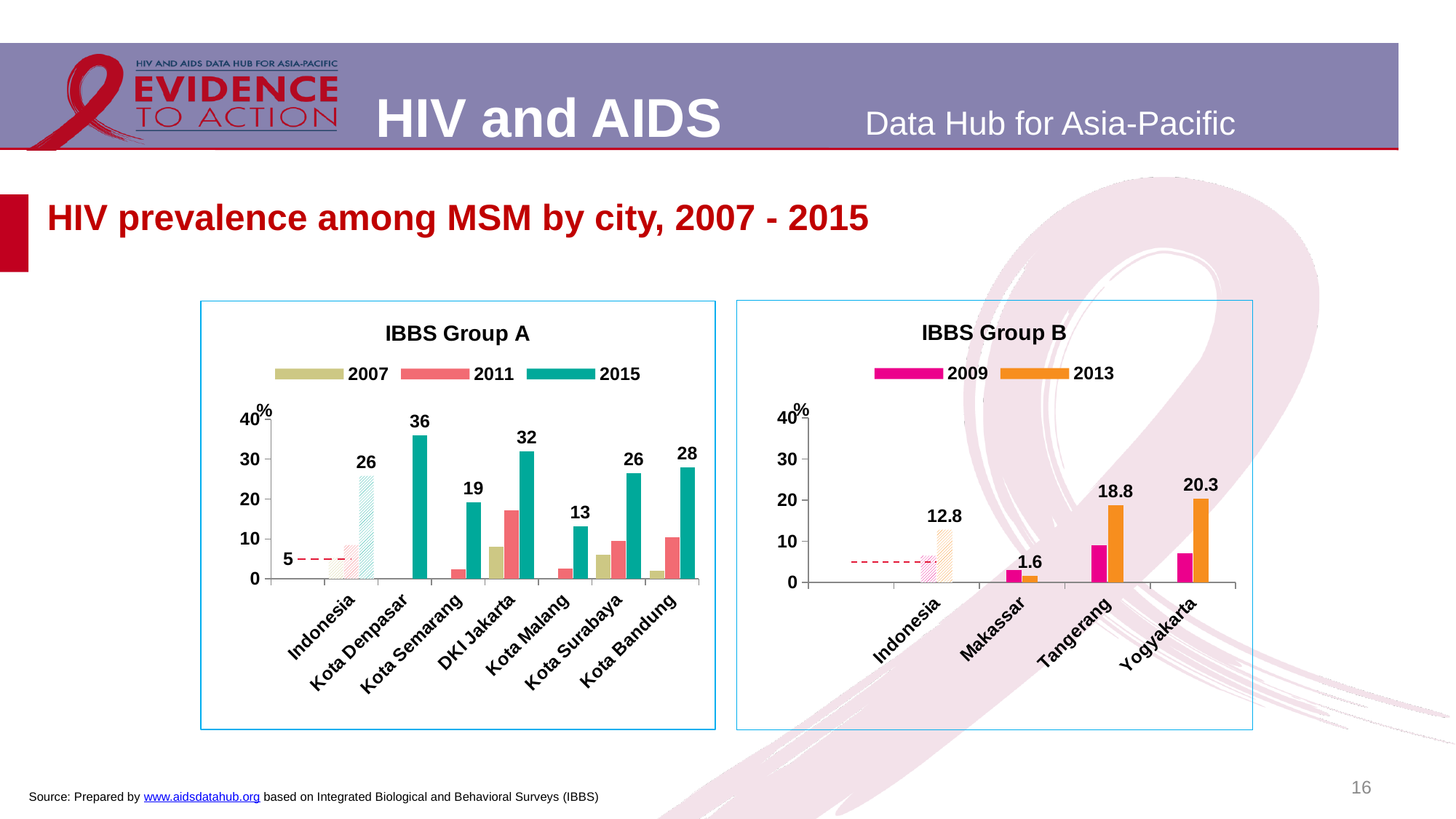
In the IBBS Group A chart, which category has the lowest 2015 value? Kota Malang In the IBBS Group B chart, which category has the highest 2013 value? Yogyakarta In the IBBS Group A chart, what is the 2015 value for Kota Denpasar? 36 In the IBBS Group B chart, what is the 2013 value for Yogyakarta? 20.3 In the IBBS Group A chart, how many series does the legend list? 3 In the IBBS Group A chart, which city has the highest 2015 value? Kota Denpasar In the IBBS Group A chart, how many categories are shown on the x axis? 7 In the IBBS Group B chart, what is the difference between the 2013 values for Yogyakarta and Tangerang? 1.5 In the IBBS Group A chart, what is the difference between the 2015 values for Kota Denpasar and DKI Jakarta? 4 In the IBBS Group B chart, which category has the lowest 2013 value? Makassar In the IBBS Group A chart, is the 2011 value for DKI Jakarta greater or less than 10? greater What kind of chart is the IBBS Group B chart? bar chart